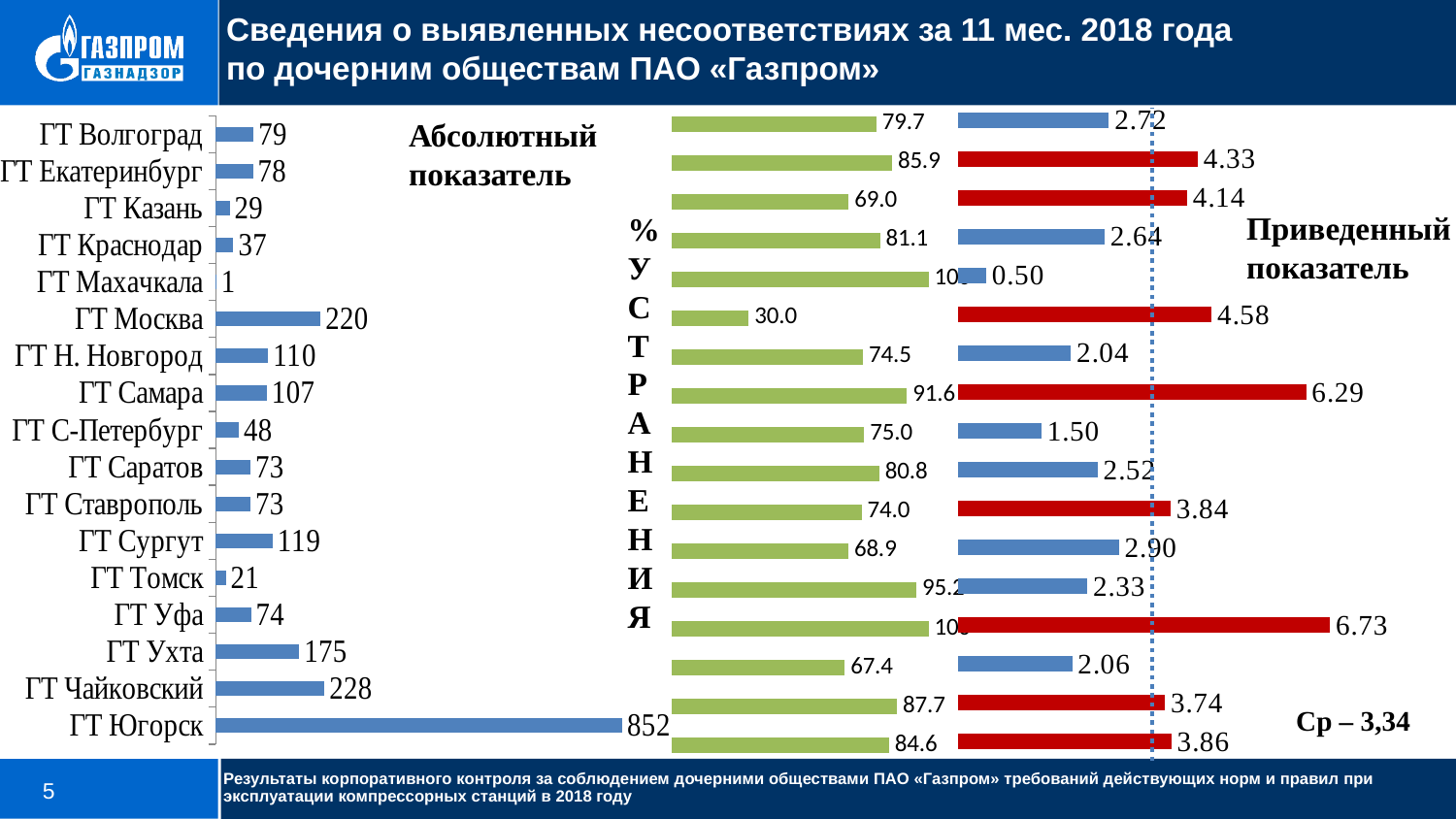
How many categories are shown on the 'Абсолютный показатель' chart? 17 On the 'Абсолютный показатель' chart, what is the value for ГТ Самара? 107 On the 'Абсолютный показатель' chart, what is the value for ГТ Югорск? 852 What average value (Ср) is shown next to the 'Приведенный показатель' chart? 3,34 On the 'Абсолютный показатель' chart, which is larger: the value for ГТ Ухта or for ГТ Сургут? ГТ Ухта On the 'Абсолютный показатель' chart, which category has the lowest value? ГТ Махачкала On the 'Абсолютный показатель' chart, what is the difference between the values for ГТ Чайковский and ГТ Москва? 8 On the 'Приведенный показатель' chart, what is the lowest value shown? 0.50 On the 'Приведенный показатель' chart, what is the highest value shown? 6.73 On the 'Абсолютный показатель' chart, which category has the highest value? ГТ Югорск What kind of chart is the 'Абсолютный показатель' chart? bar chart On the '% устранения' chart (green bars), what is the lowest value shown? 30.0